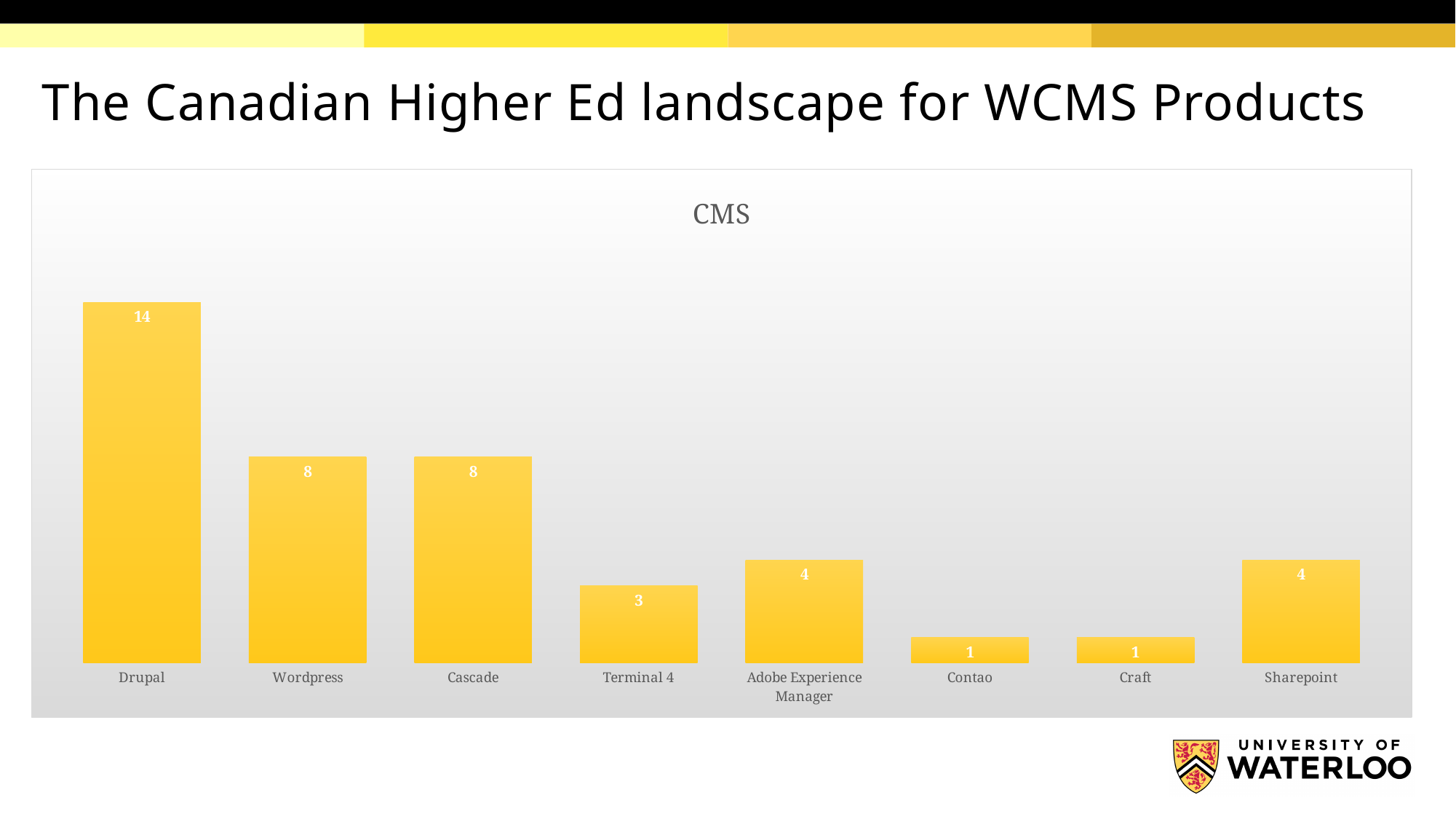
Do Wordpress and Cascade have the same value? Yes How many categories are shown on the x axis? 8 Which category has the highest value? Drupal What is the difference between the values for Sharepoint and Contao? 3 What is the difference between the values for Drupal and Wordpress? 6 What is the value for Drupal? 14 What is the value for Adobe Experience Manager? 4 Which is larger, the value for Cascade or the value for Terminal 4? Cascade What is the value for Craft? 1 What is the title of the chart? CMS What kind of chart is shown on the slide? Bar chart What is the value for Terminal 4? 3